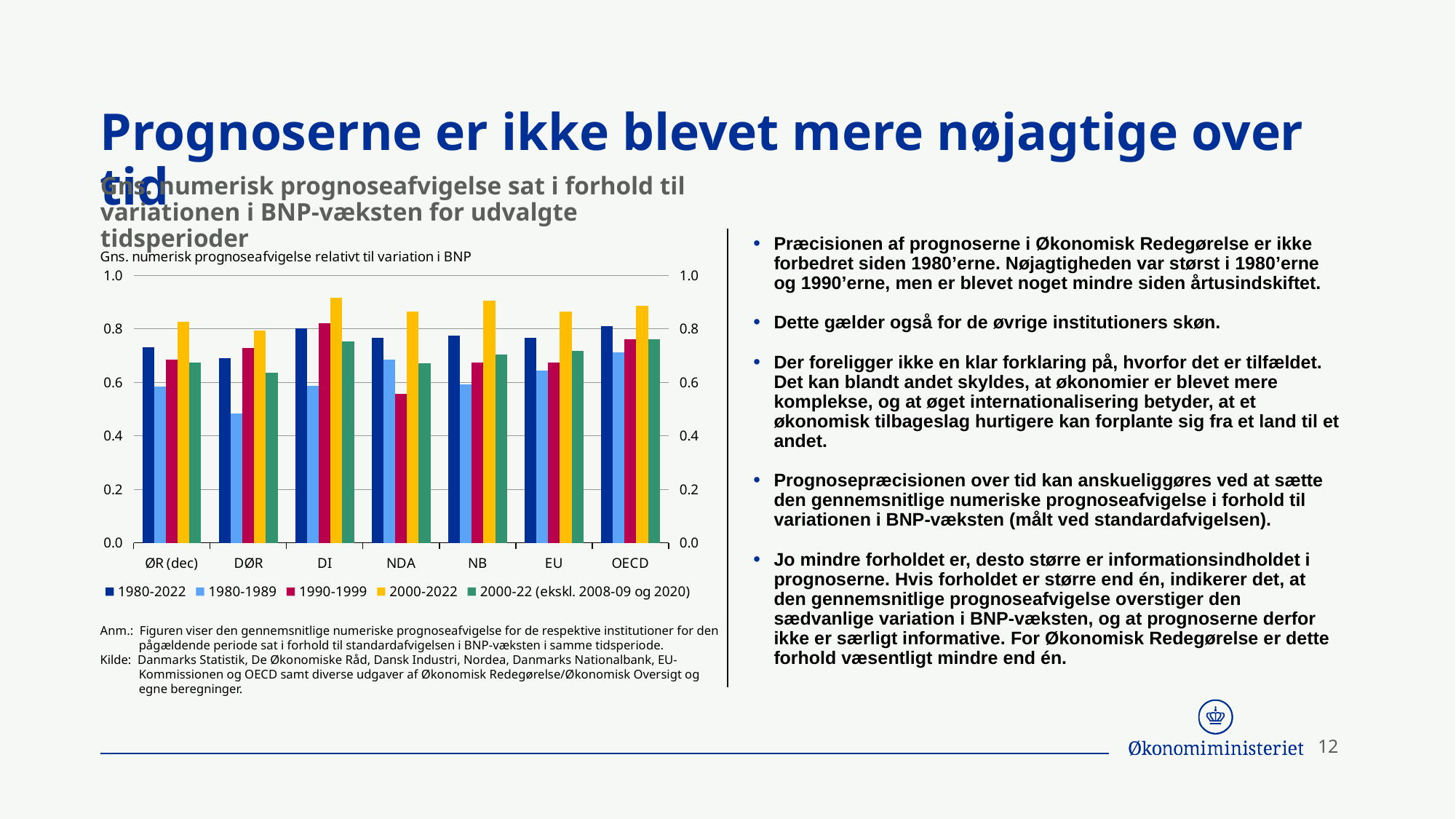
What kind of chart is shown on the slide? bar chart For DØR, which is larger: the 1980-1989 value or the 2000-2022 value? 2000-2022 Is the 1990-1999 value for NDA greater or less than 0.6? less Is the 2000-2022 value for ØR (dec) greater or less than 0.8? greater Is the 1980-1989 value for DØR greater or less than 0.6? less Which institution has the lowest 1990-1999 value? NDA How many series does the chart's legend list? 5 For NDA, which is larger: the 1980-1989 value or the 1990-1999 value? 1980-1989 Which legend entry is shown in yellow? 2000-2022 Which institution has the lowest 1980-1989 value? DØR How many institutions (categories) are shown on the x axis of the chart? 7